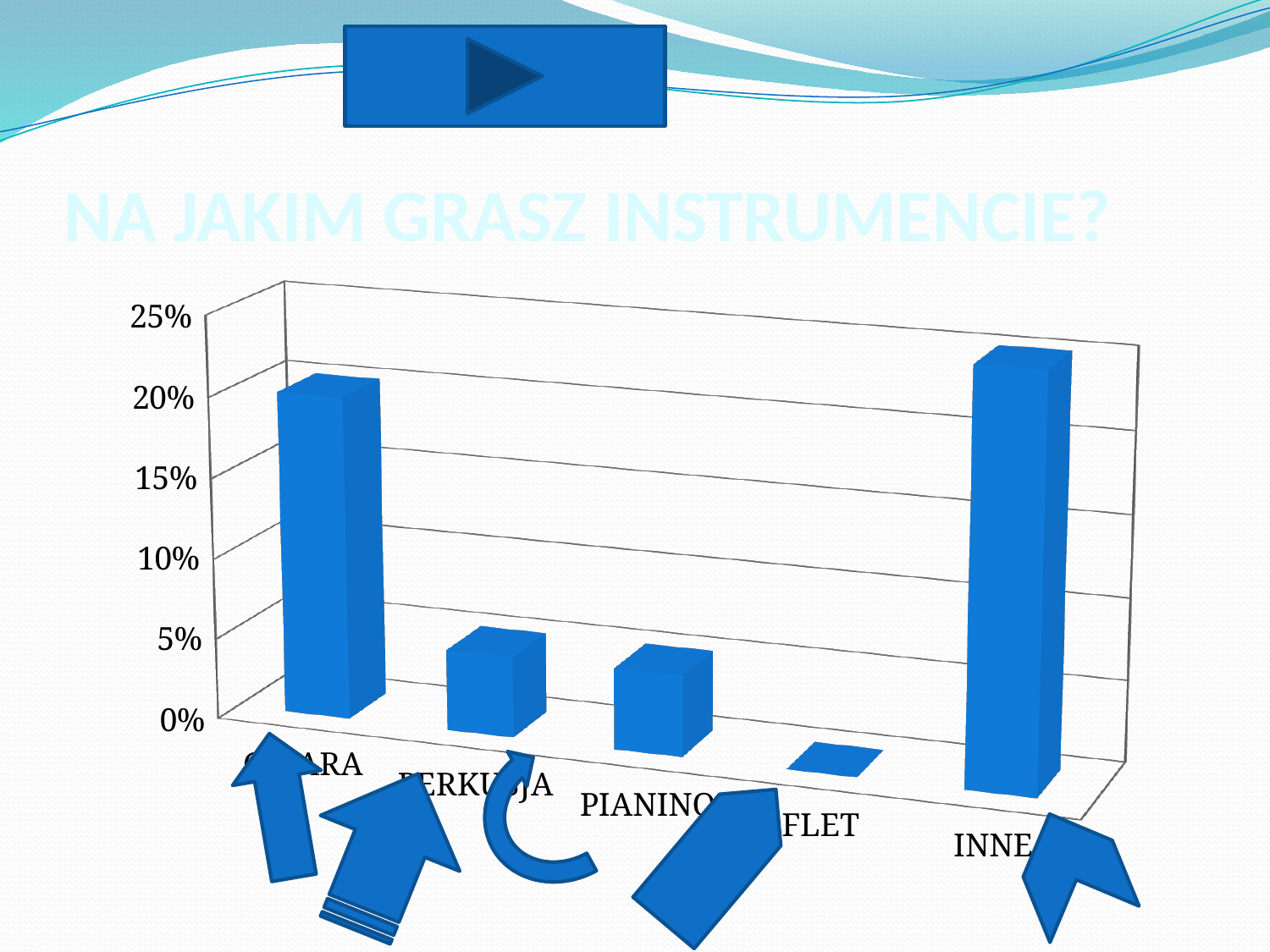
Is the value for PIANINO greater or less than 10%? less Which is larger, the value for PIANINO or the value for FLET? PIANINO What is the highest value shown on the vertical axis of the chart? 25% Is the value for INNE greater or less than 20%? greater Which is larger, the value for INNE or the value for PIANINO? INNE What is the title of the chart on the slide? NA JAKIM GRASZ INSTRUMENCIE? What kind of chart is shown on the slide? bar chart Which category has the highest bar in the chart? INNE How many instrument categories are shown on the x axis of the chart? 5 Which category has the lowest bar in the chart? FLET Is the value for FLET greater or less than 5%? less